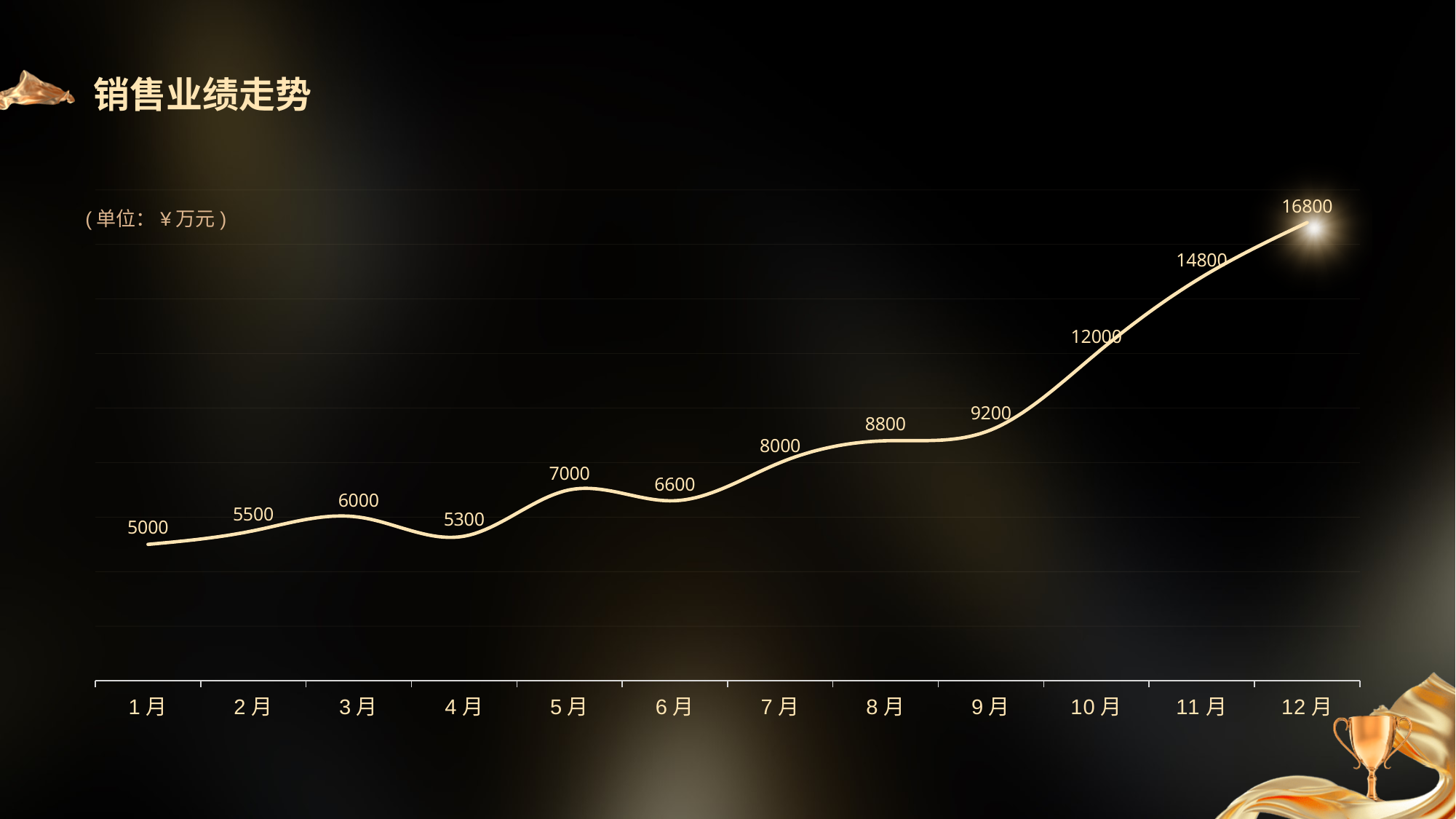
What is the value for 1月? 5000 What is the title of the chart? 销售业绩走势 How many months are plotted on the x axis? 12 What is the value for 5月? 7000 Which is larger, the value for 4月 or the value for 3月? 3月 Do the values generally rise or fall from 1月 to 12月? rise Which month has the highest value? 12月 What is the difference between the values for 12月 and 11月? 2000 Which month has the lowest value? 1月 What kind of chart is shown on the slide? line chart What is the value for 10月? 12000 What is the difference between the values for 6月 and 5月? 400